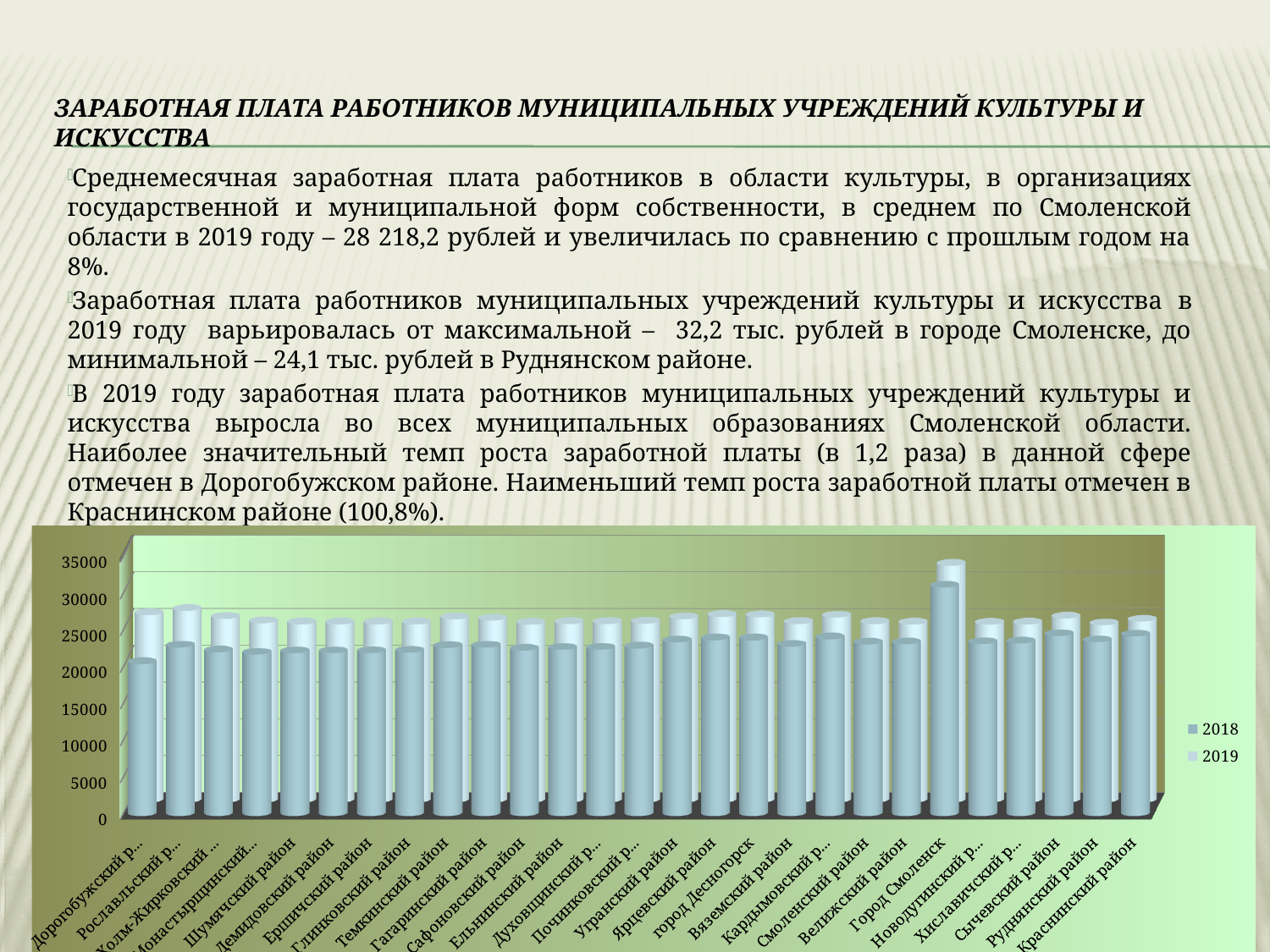
Is the 2019 value for Ярцевский район greater or less than 20000? greater Which category has the lowest 2018 bar in the chart? Дорогобужский район For Город Смоленск, which series has the larger value, 2018 or 2019? 2019 Which is larger in 2019: Город Смоленск or Вяземский район? Город Смоленск Which years are listed in the chart legend? 2018 and 2019 What is the highest tick value shown on the vertical axis of the chart? 35000 How many districts (categories) are plotted on the x axis of the chart? 27 Is the 2018 value for Дорогобужский район greater or less than 25000? less Which category has the highest bar in the chart? Город Смоленск How many series does the chart legend list? 2 Is the 2019 value for Город Смоленск greater or less than 30000? greater What kind of chart is shown on the slide? bar chart